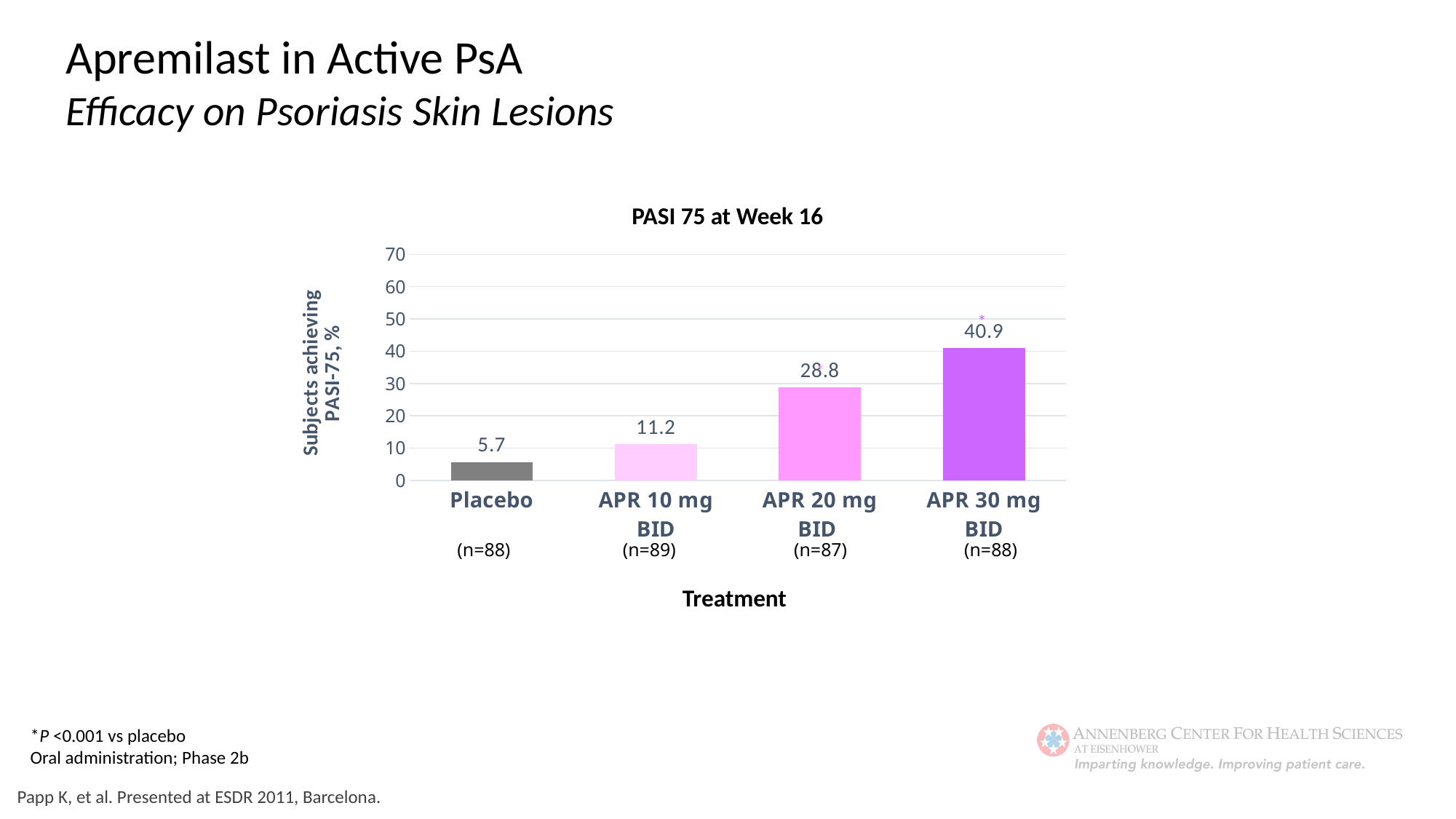
What is the value for APR 30 mg BID? 40.9 What is the difference between the values for APR 30 mg BID and Placebo? 35.2 Which is larger, the value for APR 20 mg BID or APR 10 mg BID? APR 20 mg BID What is the title of the chart? PASI 75 at Week 16 How many treatment groups are shown in the chart? 4 What is the value for APR 20 mg BID? 28.8 Which treatment has the highest percentage of subjects achieving PASI-75? APR 30 mg BID What kind of chart is shown on the slide? bar chart What is the value for Placebo? 5.7 What is the value for APR 10 mg BID? 11.2 Which treatment has the lowest percentage of subjects achieving PASI-75? Placebo Is the value for APR 30 mg BID greater or less than 40? greater